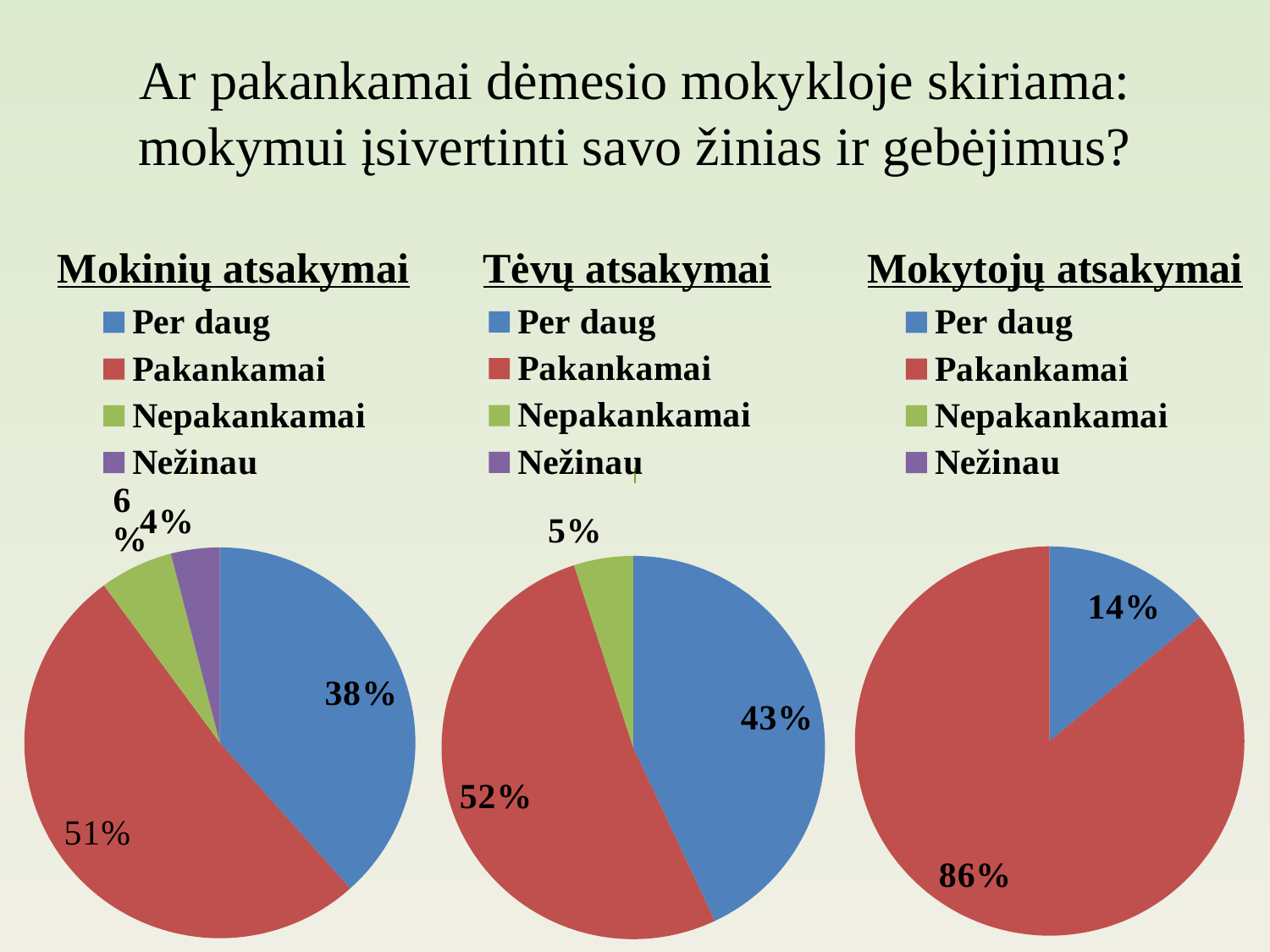
In the "Tėvų atsakymai" chart, what is the difference between "Pakankamai" and "Per daug"? 9% Which is larger: "Per daug" in the "Mokinių atsakymai" chart or "Per daug" in the "Tėvų atsakymai" chart? Tėvų atsakymai In the "Tėvų atsakymai" chart, what is the value for "Per daug"? 43% In the "Mokinių atsakymai" chart, what is the value for "Per daug"? 38% In the "Mokytojų atsakymai" chart, what is the difference between "Pakankamai" and "Per daug"? 72% In the "Mokinių atsakymai" chart, what colour is the "Nepakankamai" slice? Green In the "Tėvų atsakymai" chart, which category has the largest slice? Pakankamai In the "Mokinių atsakymai" chart, what share of the pie is "Pakankamai"? 51% In the "Mokinių atsakymai" chart, which category has the smallest slice? Nežinau In the "Mokytojų atsakymai" chart, what is the value for "Pakankamai"? 86% How many entries does the legend of the "Tėvų atsakymai" chart list? 4 What kind of chart is the "Mokytojų atsakymai" chart? Pie chart